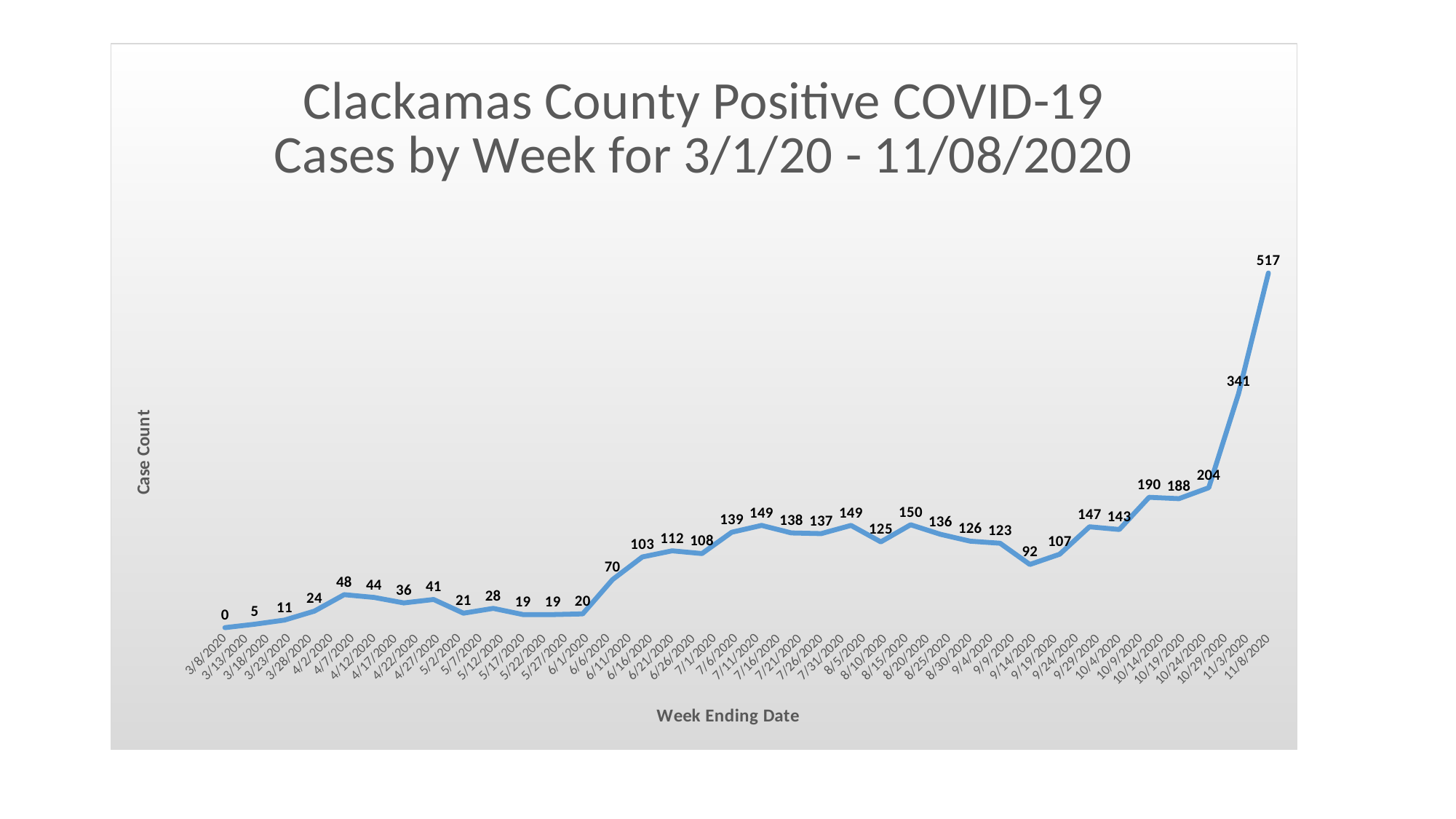
What is the case count for the week ending 3/8/2020? 0 What is the case count for the week ending 11/8/2020? 517 What is the title of the vertical axis? Case Count How many data points are plotted on the line? 36 What is the title of the horizontal axis? Week Ending Date What kind of chart is shown on the slide? line chart Do the case counts generally rise or fall from left to right across the chart? rise What is the highest weekly case count shown on the chart? 517 Which is larger, the data point labeled 341 or the data point labeled 204? 341 What is the difference between the last data point (517) and the one before it (341)? 176 What is the difference between the data points labeled 204 and 188? 16 What is the lowest weekly case count shown on the chart? 0